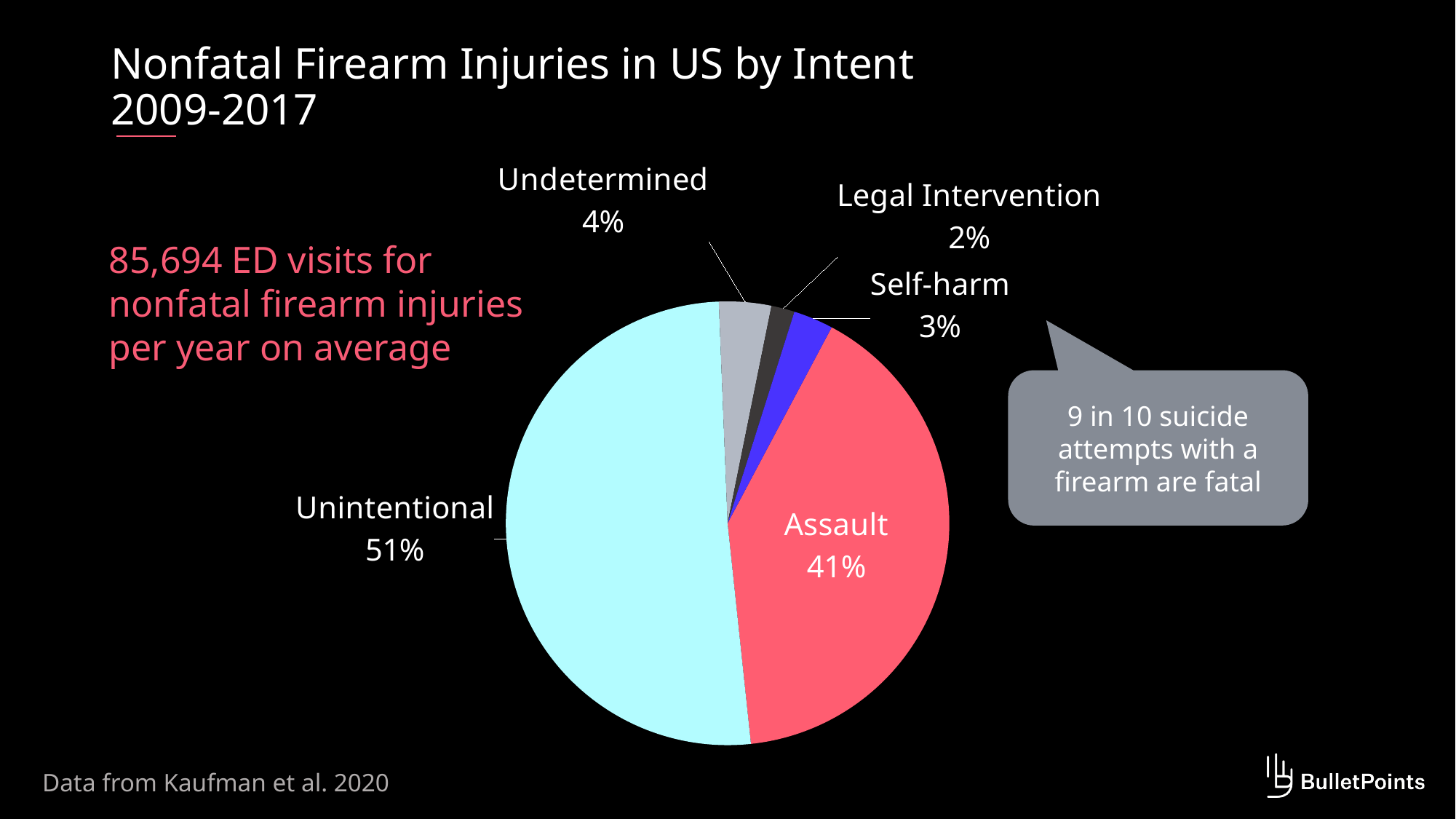
What share of nonfatal firearm injuries is attributed to Assault? 41% What share of nonfatal firearm injuries is attributed to Legal Intervention? 2% What share of nonfatal firearm injuries is attributed to Unintentional? 51% What is the difference in percentage points between the Unintentional and Assault slices? 10 Which slice is larger, Undetermined or Self-harm? Undetermined What share of nonfatal firearm injuries is attributed to Self-harm? 3% Which intent category has the smallest share of the pie? Legal Intervention Which intent category has the largest share of the pie? Unintentional What share of nonfatal firearm injuries is attributed to Undetermined? 4% What is the title of the chart on the slide? Nonfatal Firearm Injuries in US by Intent 2009-2017 What kind of chart is shown on the slide? pie chart How many intent categories are shown in the pie chart? 5